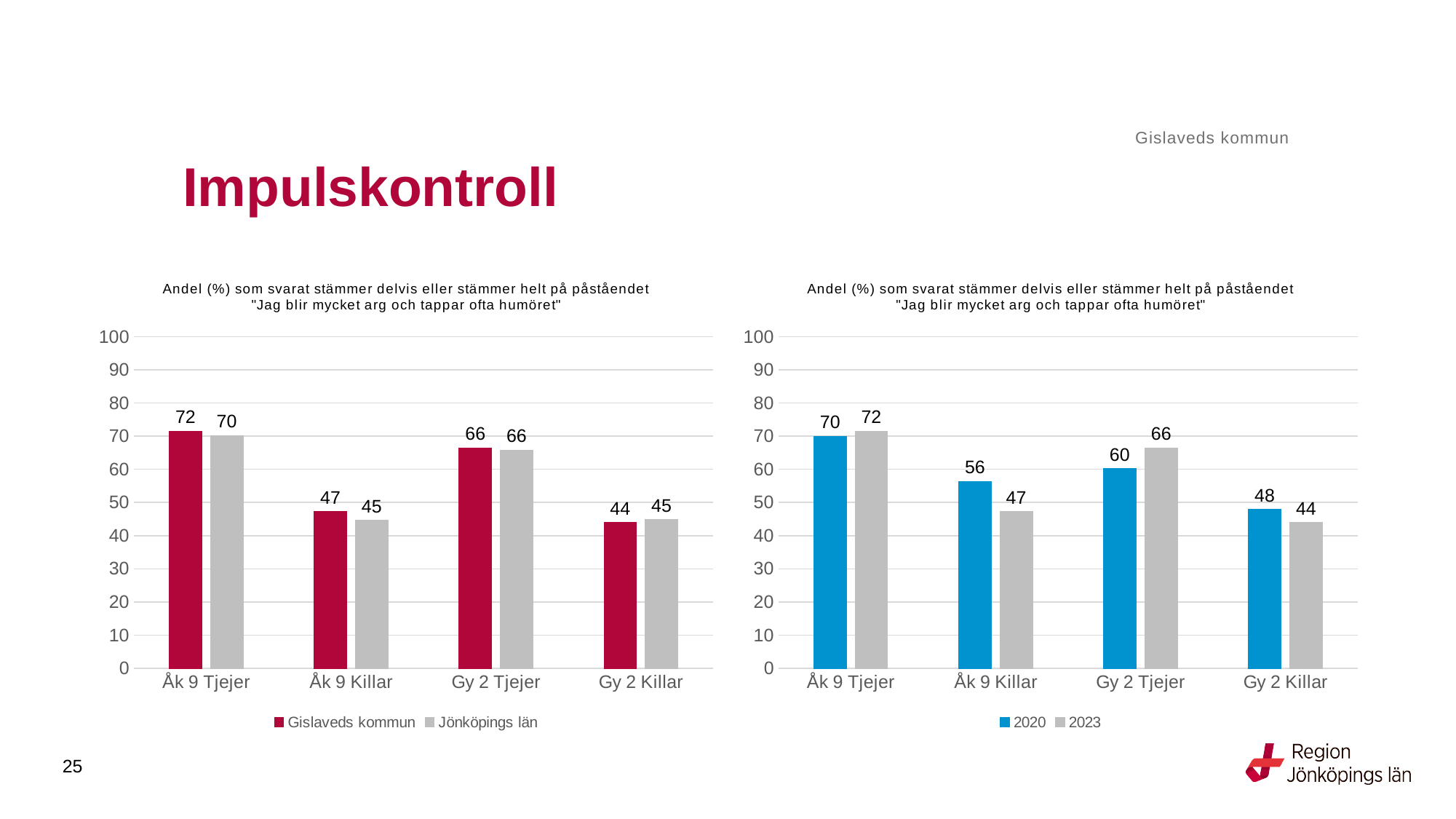
How many series does the legend of the right chart list? 2 In the right chart, what is the value for 2020 for Åk 9 Killar? 56 In the right chart, what is the difference between the 2020 and 2023 values for Åk 9 Killar? 9 In the right chart, what is the value for 2023 for Gy 2 Tjejer? 66 In the left chart, which is larger for Åk 9 Killar: Gislaveds kommun or Jönköpings län? Gislaveds kommun In the left chart, what is the value for Jönköpings län for Gy 2 Killar? 45 How many categories are shown on the x axis of the left chart? 4 In the right chart, is the 2020 value for Gy 2 Tjejer greater or less than 50? greater In the left chart, what is the value for Gislaveds kommun for Åk 9 Tjejer? 72 In the right chart, which category has the highest value for 2023? Åk 9 Tjejer What kind of chart is the left chart? Bar chart In the left chart, which category has the lowest value for Gislaveds kommun? Gy 2 Killar